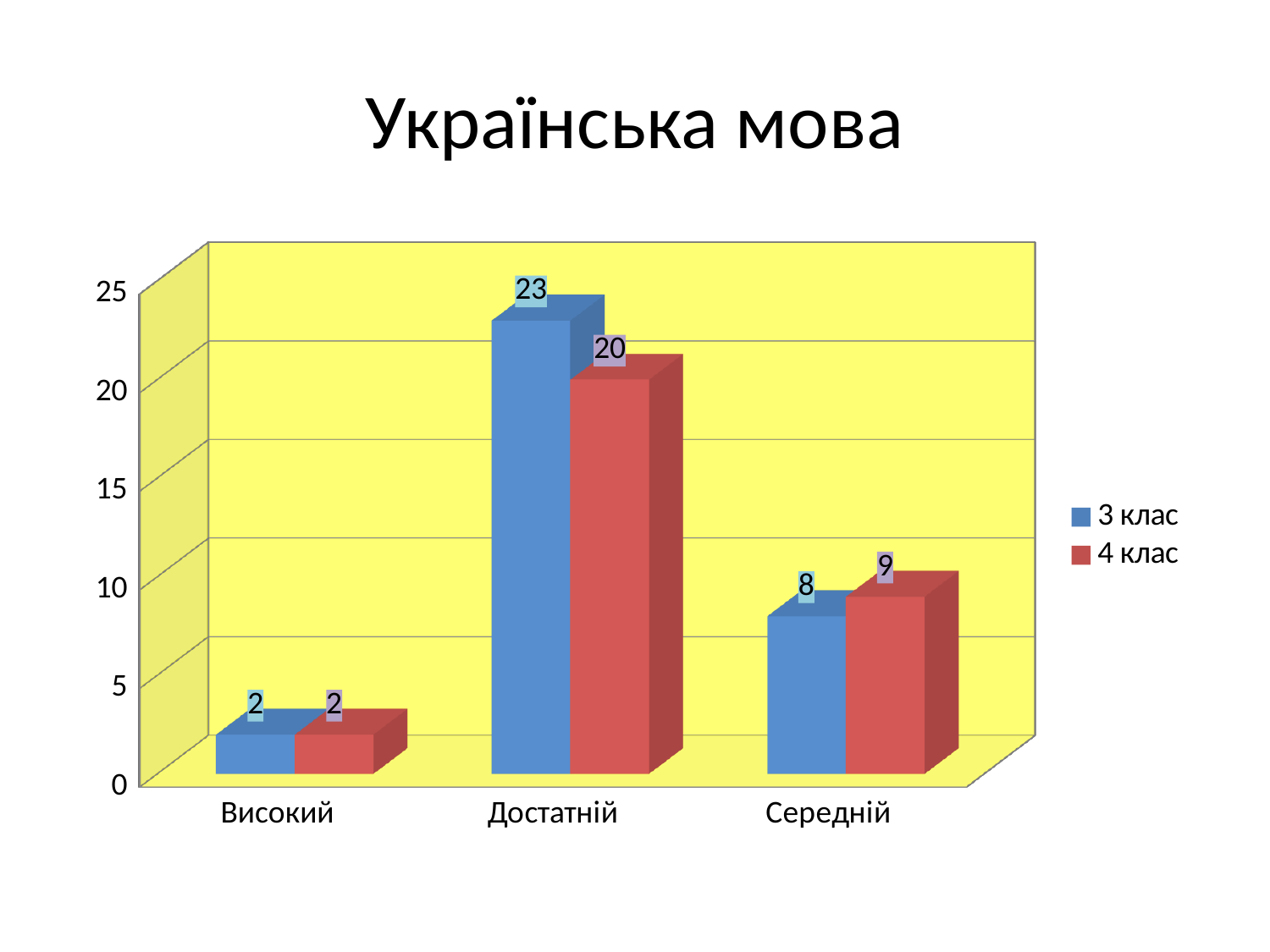
What is the value for 4 клас in the Середній category? 9 Which category has the lowest value for 3 клас? Високий What is the value for 3 клас in the Достатній category? 23 How many series does the legend list? 2 What is the difference between 3 клас and 4 клас in the Достатній category? 3 What is the value for 4 клас in the Високий category? 2 Which category has the highest value for 4 клас? Достатній How many categories are shown on the x axis? 3 What is the title of the slide? Українська мова What kind of chart is shown on the slide? bar chart In the Середній category, which series has the larger value, 3 клас or 4 клас? 4 клас Is the value for 4 клас in the Достатній category greater or less than 15? greater